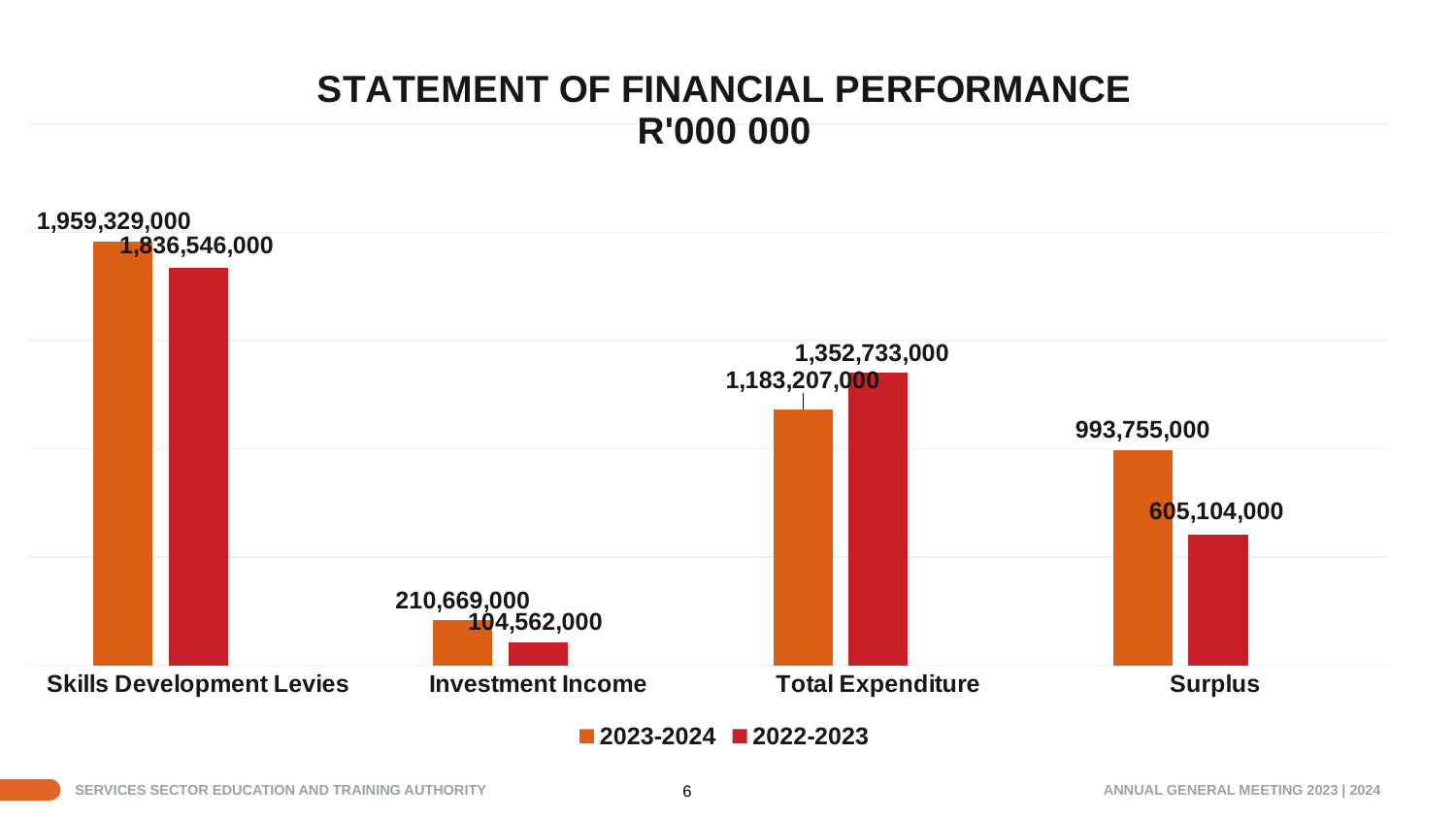
How many categories are shown on the x axis? 4 How many series does the legend list? 2 What is the difference between the 2022-2023 and 2023-2024 values for Total Expenditure? 169,526,000 What is the difference between the 2023-2024 and 2022-2023 values for Surplus? 388,651,000 What is the 2023-2024 value for Skills Development Levies? 1,959,329,000 What kind of chart is shown on the slide? Bar chart For Total Expenditure, which year has the larger value, 2023-2024 or 2022-2023? 2022-2023 What is the 2022-2023 value for Investment Income? 104,562,000 Which category has the lowest 2022-2023 value? Investment Income Which category has the highest 2023-2024 value? Skills Development Levies What is the 2023-2024 value for Surplus? 993,755,000 What is the 2022-2023 value for Total Expenditure? 1,352,733,000